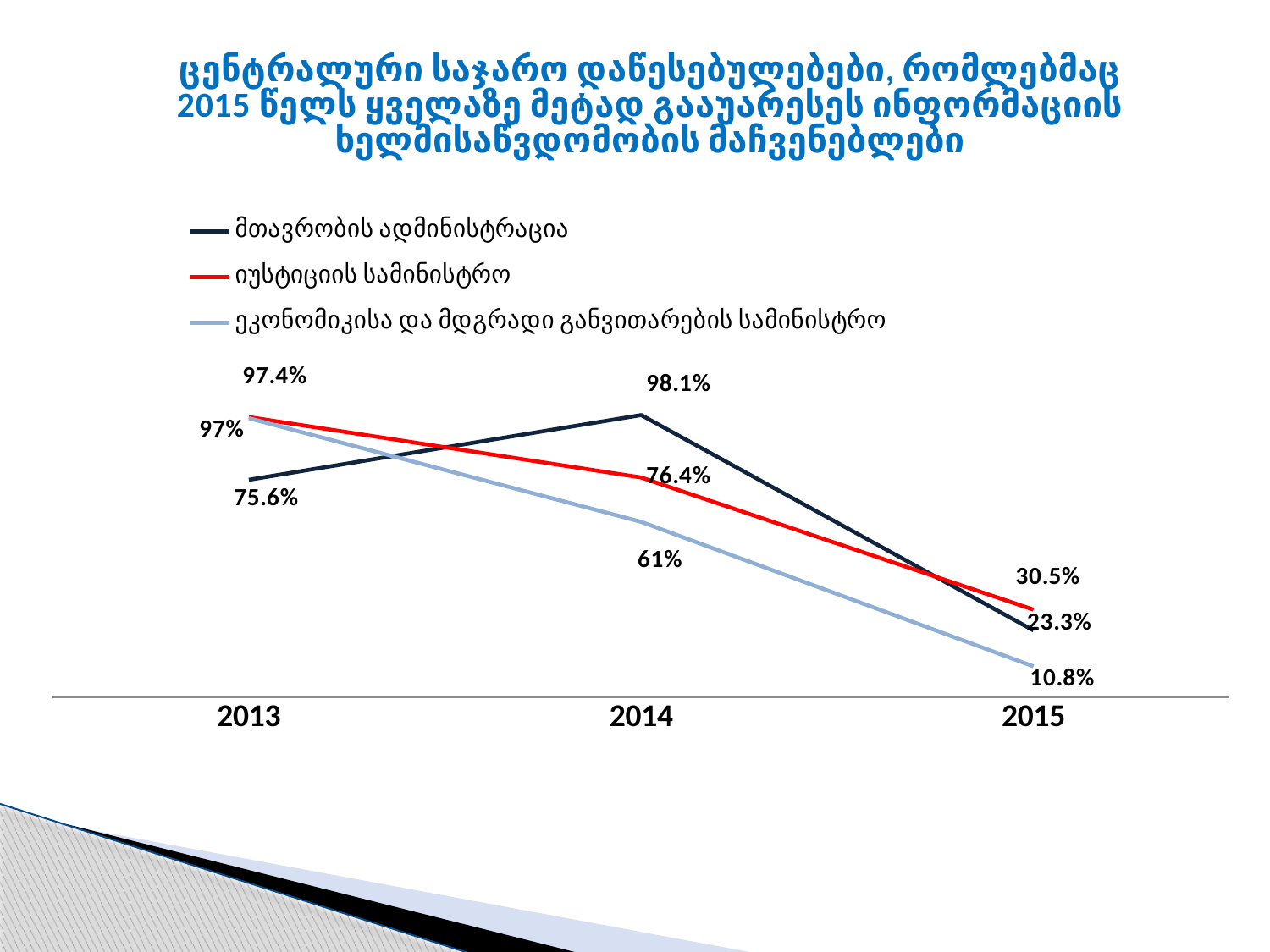
What is the value for ეკონომიკისა და მდგრადი განვითარების სამინისტრო in 2014? 61% Which series has the lowest value in 2015? ეკონომიკისა და მდგრადი განვითარების სამინისტრო What is the value for მთავრობის ადმინისტრაცია in 2013? 75.6% What is the value for მთავრობის ადმინისტრაცია in 2014? 98.1% What is the difference between the 2014 and 2015 values for მთავრობის ადმინისტრაცია? 74.8% What is the value for იუსტიციის სამინისტრო in 2015? 30.5% Which series has the highest value in 2014? მთავრობის ადმინისტრაცია Does the value for იუსტიციის სამინისტრო rise or fall from 2014 to 2015? fall How many series does the legend list? 3 What type of chart is shown on the slide? line chart How many years are shown on the x axis? 3 What is the value for ეკონომიკისა და მდგრადი განვითარების სამინისტრო in 2015? 10.8%